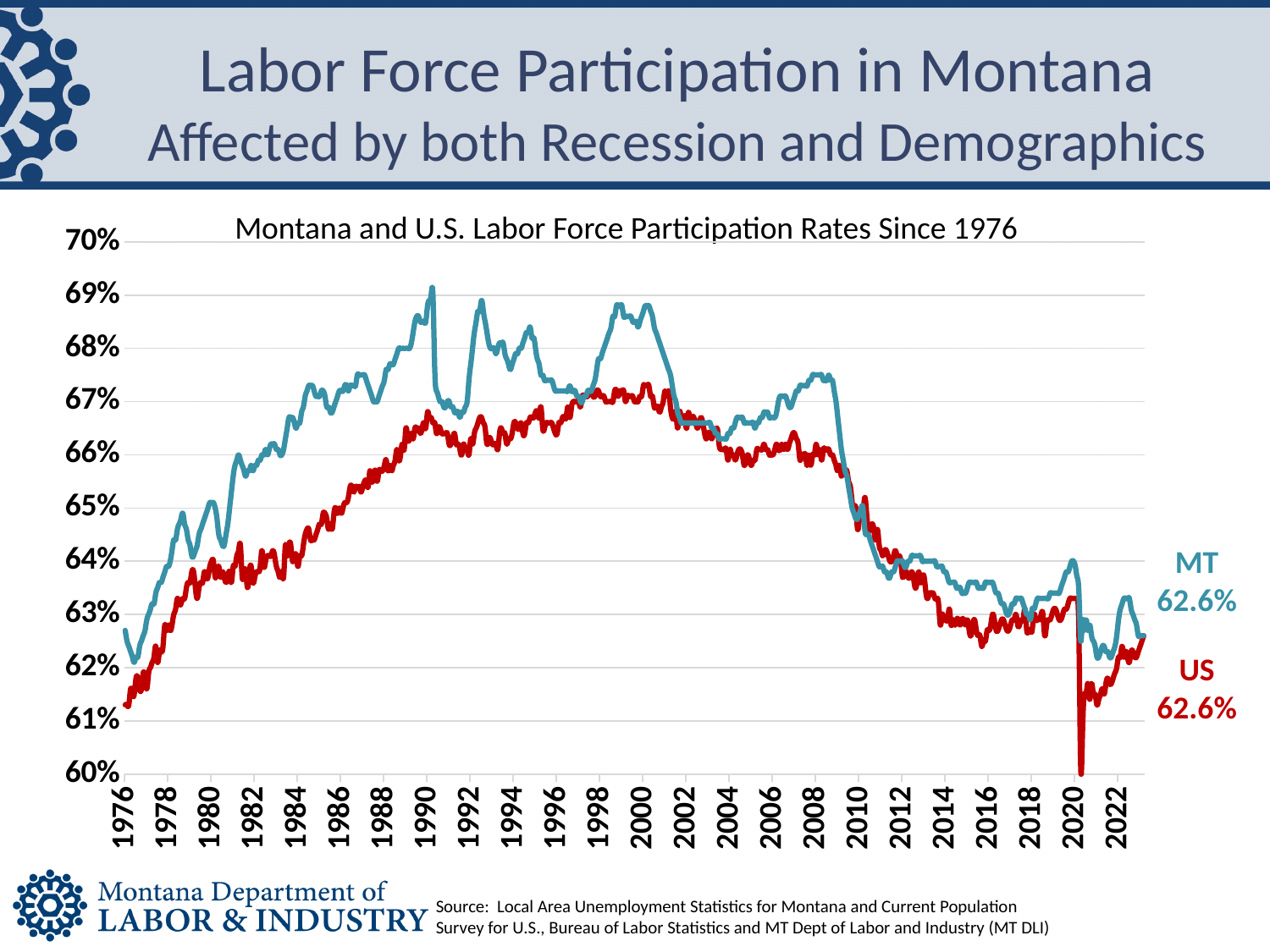
Does the MT participation rate generally rise or fall between 2008 and 2014? Fall What is the most recent labor force participation rate shown for the US? 62.6% What is the title of the chart? Montana and U.S. Labor Force Participation Rates Since 1976 How many series are plotted on the chart? 2 Around 1990, is the MT participation rate greater or less than 68%? greater In 1976, is the US participation rate greater or less than 62%? less What is the most recent labor force participation rate shown for MT? 62.6% What kind of chart is shown on the slide? Line chart Around 1990, which series has the higher participation rate, MT or US? MT At its dip in 2020, is the US participation rate greater or less than 61%? less What is the difference between the latest MT rate and the latest US rate shown on the chart? 0 Around 2008, which series has the higher participation rate, MT or US? MT